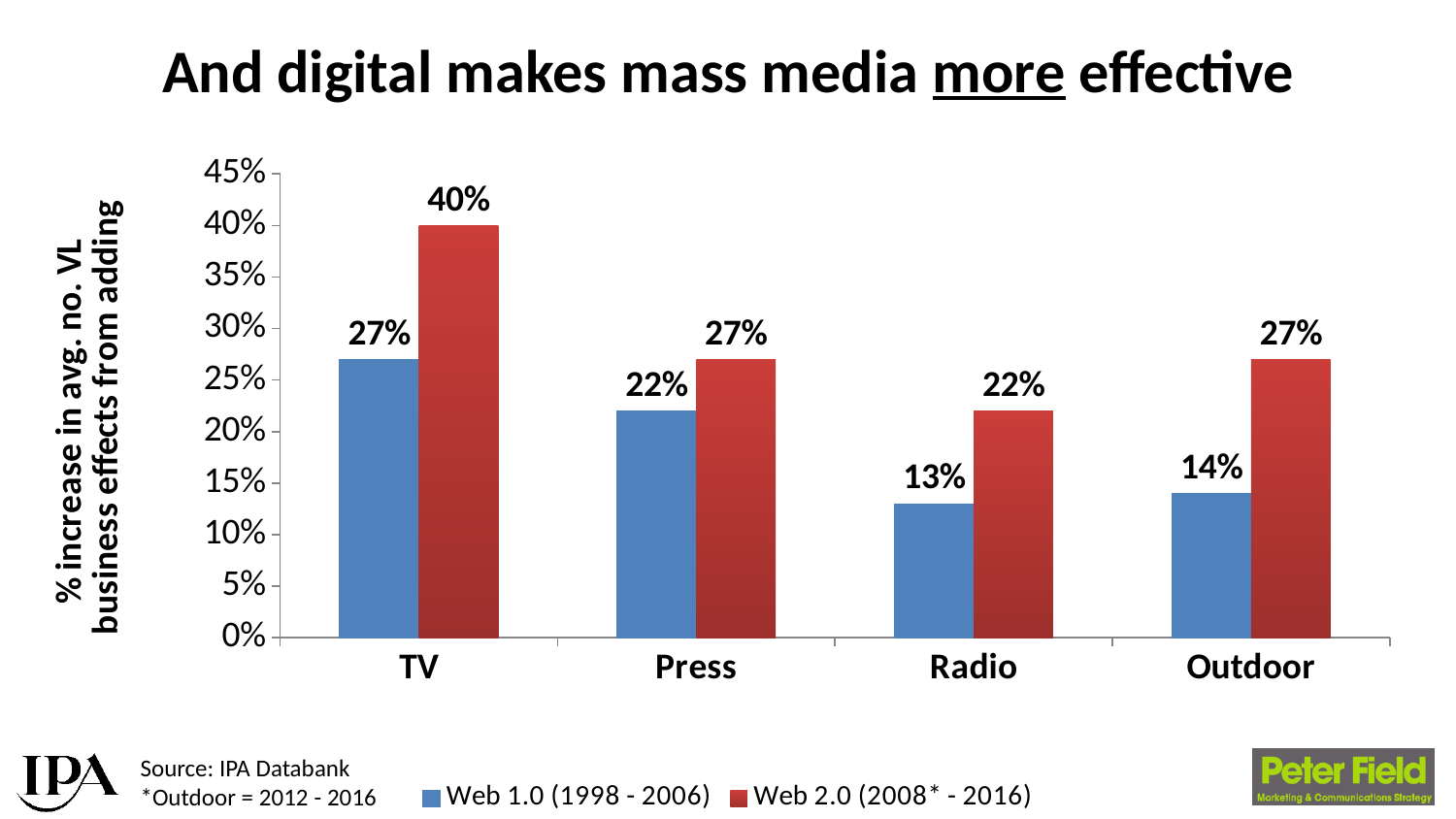
What is the difference between the Web 2.0 and Web 1.0 values for TV? 13% Which category has the lowest value in the Web 1.0 (1998 - 2006) series? Radio What colour are the bars for the Web 2.0 (2008* - 2016) series? Red What is the value for Radio in the Web 1.0 (1998 - 2006) series? 13% Which category has the highest value in the Web 2.0 (2008* - 2016) series? TV Which is larger for Press: the Web 1.0 (1998 - 2006) value or the Web 2.0 (2008* - 2016) value? Web 2.0 (2008* - 2016) How many series does the legend list? 2 What is the value for TV in the Web 2.0 (2008* - 2016) series? 40% What is the difference between the Web 2.0 and Web 1.0 values for Outdoor? 13% How many categories are shown on the x axis? 4 What kind of chart is shown on the slide? Bar chart What is the value for Outdoor in the Web 2.0 (2008* - 2016) series? 27%